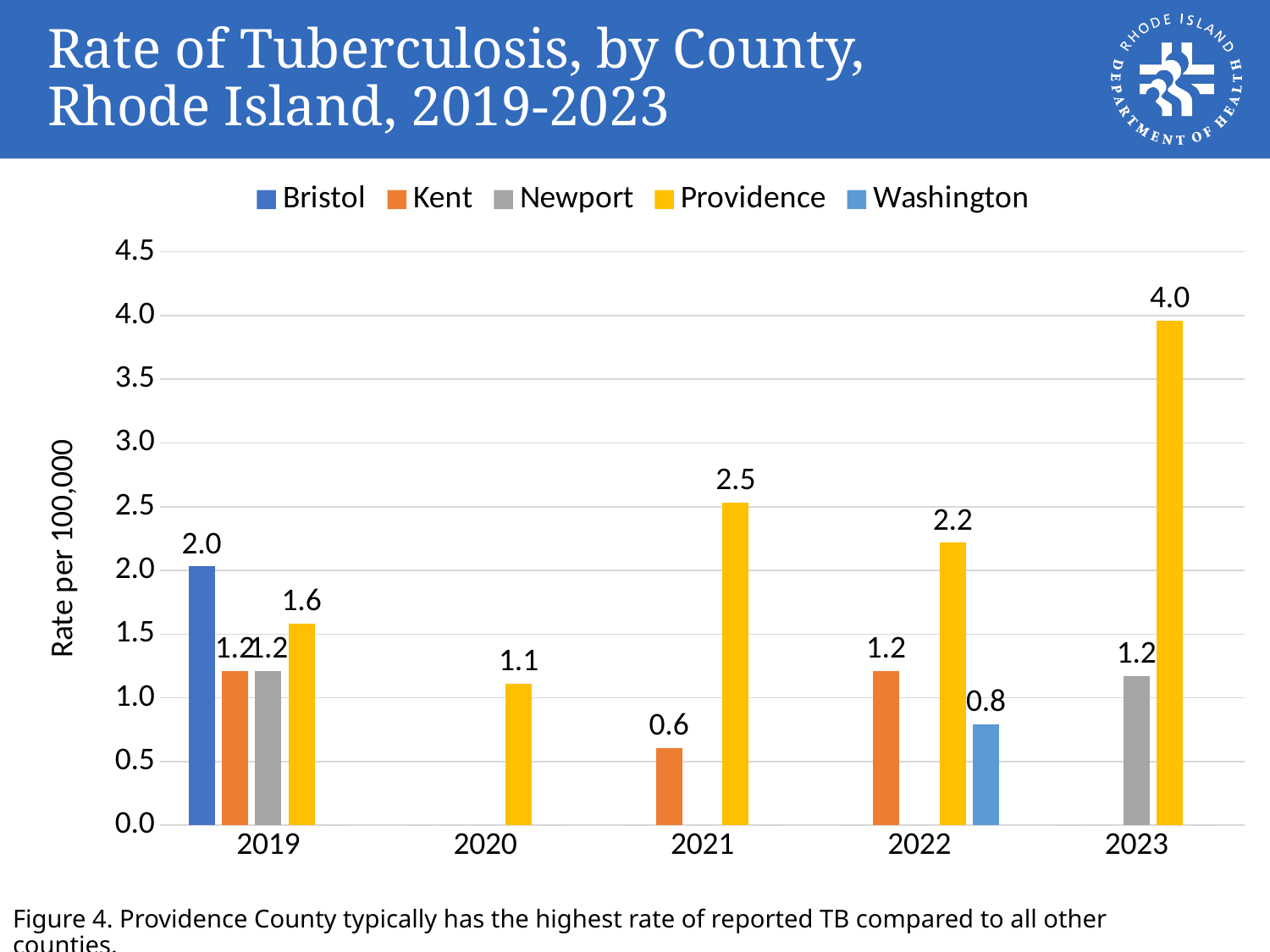
What is the label of the y axis? Rate per 100,000 In which year does Providence County have its highest rate of tuberculosis? 2023 In which year does Providence County have its lowest rate of tuberculosis? 2020 How many counties are listed in the legend? 5 Which county has the higher rate in 2019, Bristol or Providence? Bristol What is the rate of tuberculosis for Washington County in 2022? 0.8 What type of chart is shown on the slide? Bar chart What is the rate of tuberculosis for Bristol County in 2019? 2.0 What is the rate of tuberculosis for Providence County in 2023? 4.0 What is the rate of tuberculosis for Kent County in 2021? 0.6 What is the difference between the Providence County rate in 2023 and in 2022? 1.8 How many years are shown on the x axis? 5